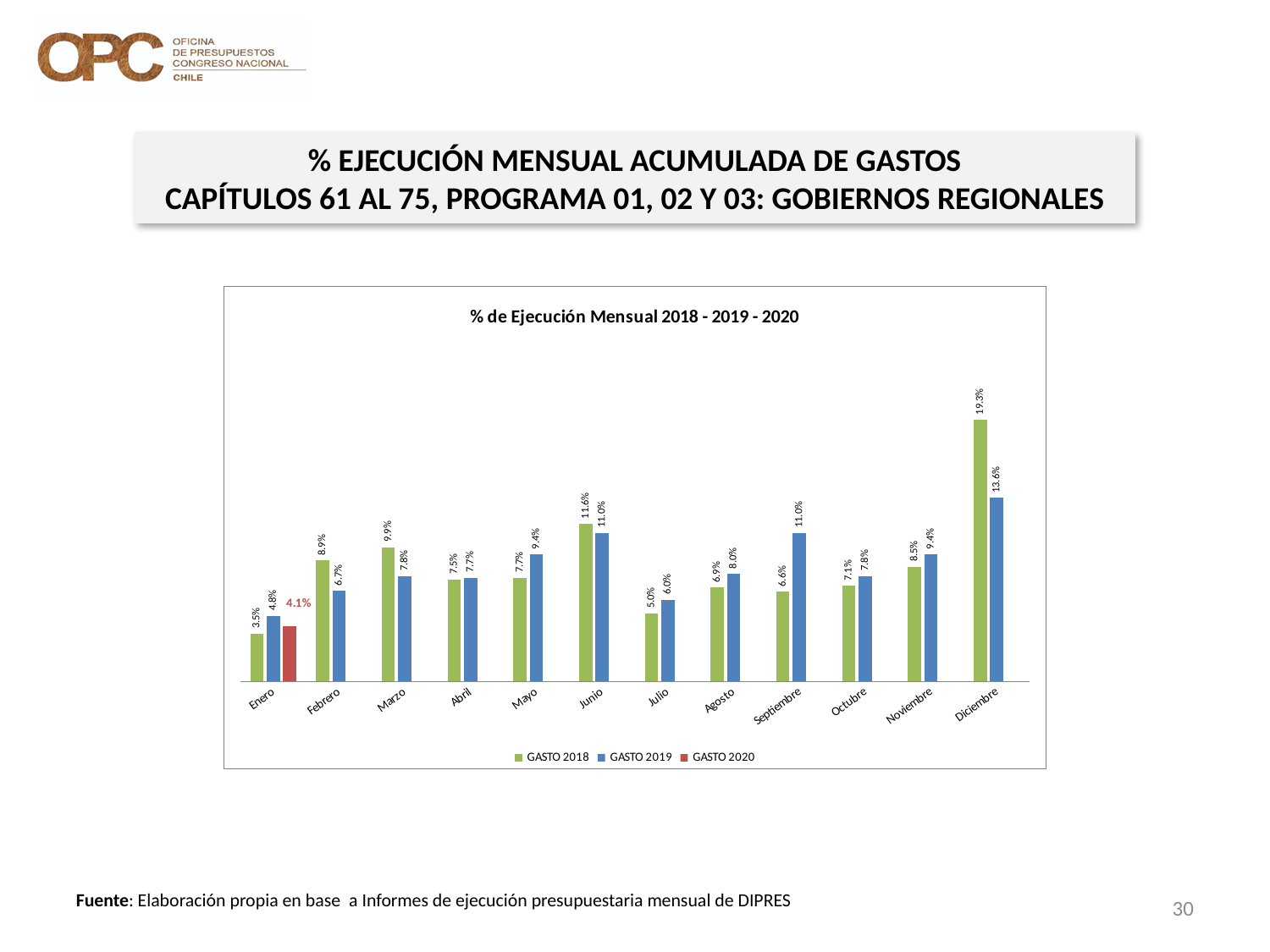
How many series does the legend list? 3 How many months are shown on the x axis? 12 Which month has the lowest GASTO 2018 value? Enero What is the difference between the GASTO 2019 and GASTO 2018 values for Enero? 1.3% What is the title of the chart? % de Ejecución Mensual 2018 - 2019 - 2020 What is the GASTO 2018 value for Diciembre? 19.3% What is the GASTO 2019 value for Septiembre? 11.0% What is the GASTO 2020 value for Enero? 4.1% Which month has the highest GASTO 2019 value? Diciembre Which is larger for Septiembre, GASTO 2018 or GASTO 2019? GASTO 2019 What is the difference between the GASTO 2018 and GASTO 2019 values for Diciembre? 5.7% What kind of chart is shown? Bar chart